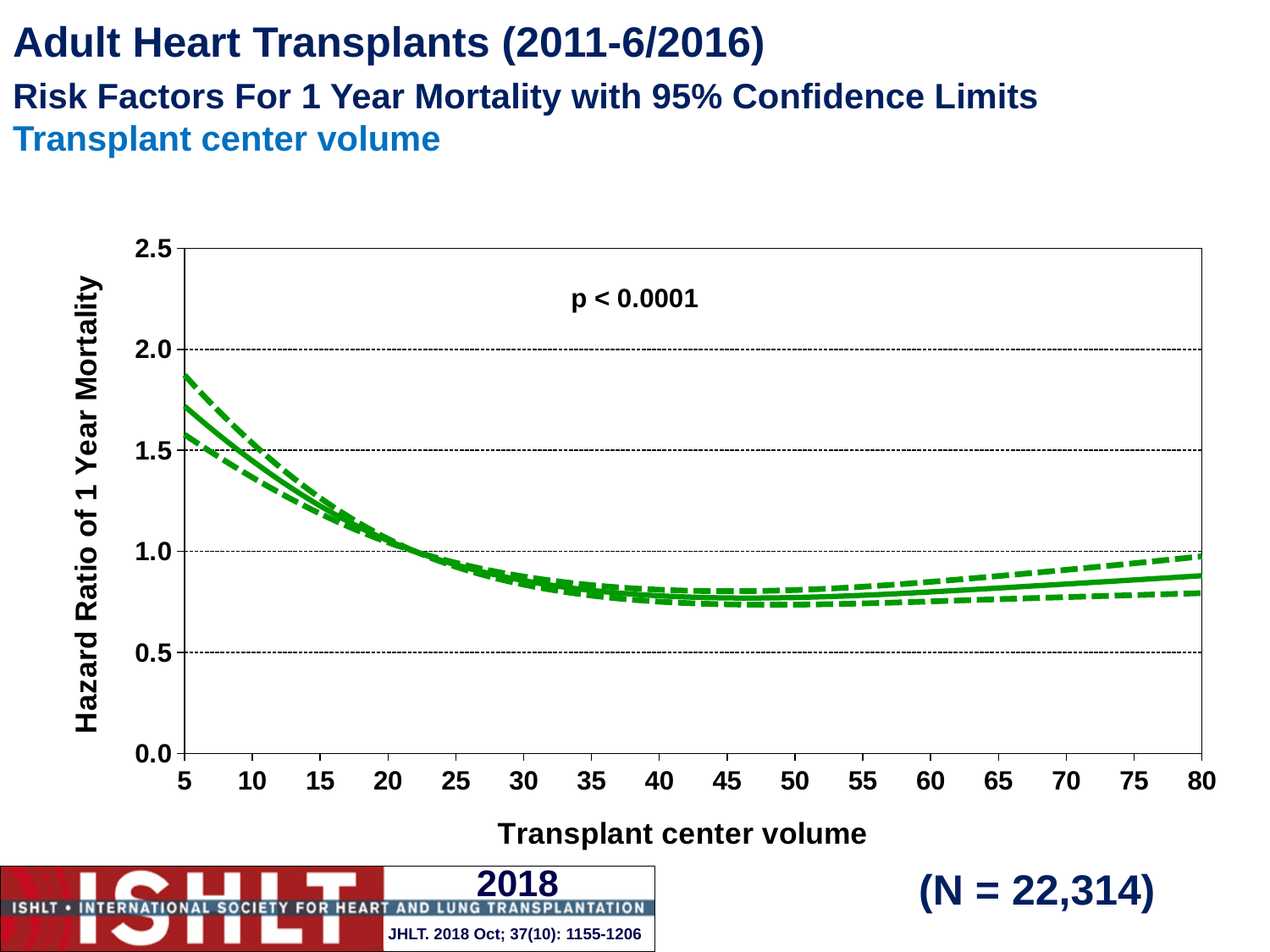
Is the hazard ratio (solid line) at a transplant center volume of 40 greater or less than 1.0? less Is the hazard ratio (solid line) at a transplant center volume of 5 greater or less than 1.5? greater Which is larger, the hazard ratio at a transplant center volume of 10 or at 60? 10 How many tick labels are shown on the x axis? 16 Is the upper 95% confidence limit (upper dashed line) at a transplant center volume of 5 greater or less than 2.0? less Does the hazard ratio rise or fall as transplant center volume increases from 5 to 40? fall What is the label of the x axis? Transplant center volume What is the label of the y axis? Hazard Ratio of 1 Year Mortality What kind of chart is shown on the slide? line chart At which transplant center volume shown on the x axis is the hazard ratio highest? 5